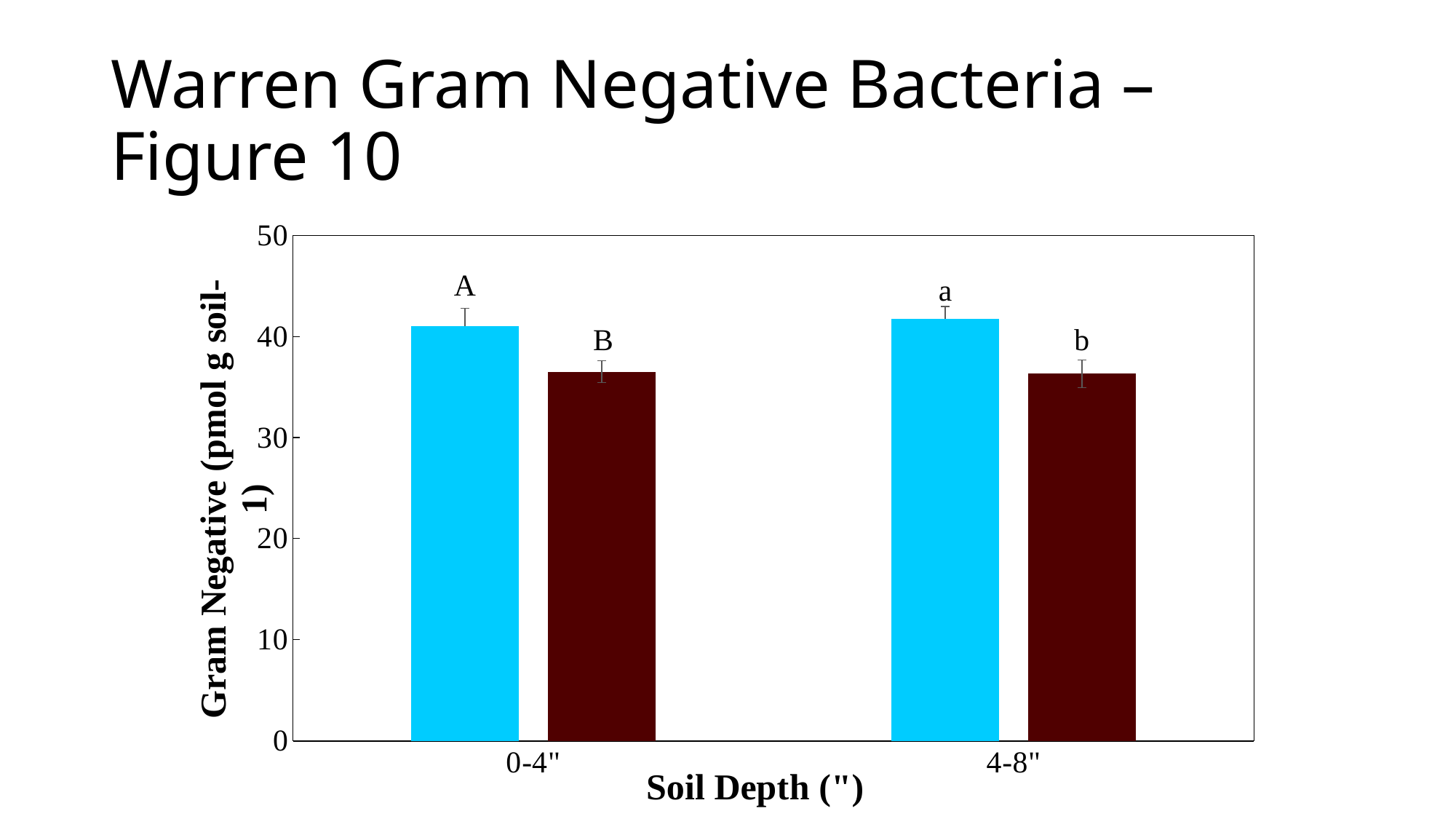
What kind of chart is shown on the slide? bar chart Is the value of the dark red bar at 0-4" greater or less than 40? less How many soil depth categories are shown on the x axis? 2 Is the value of the dark red bar at 4-8" greater or less than 30? greater Is the value of the light blue bar at 0-4" greater or less than 40? greater At the 0-4" soil depth, which bar is taller, the light blue bar or the dark red bar? the light blue bar How many bars are plotted for each soil depth category? 2 What is the label of the x axis? Soil Depth (") What is the maximum value shown on the y axis? 50 At the 4-8" soil depth, which bar is taller, the light blue bar or the dark red bar? the light blue bar